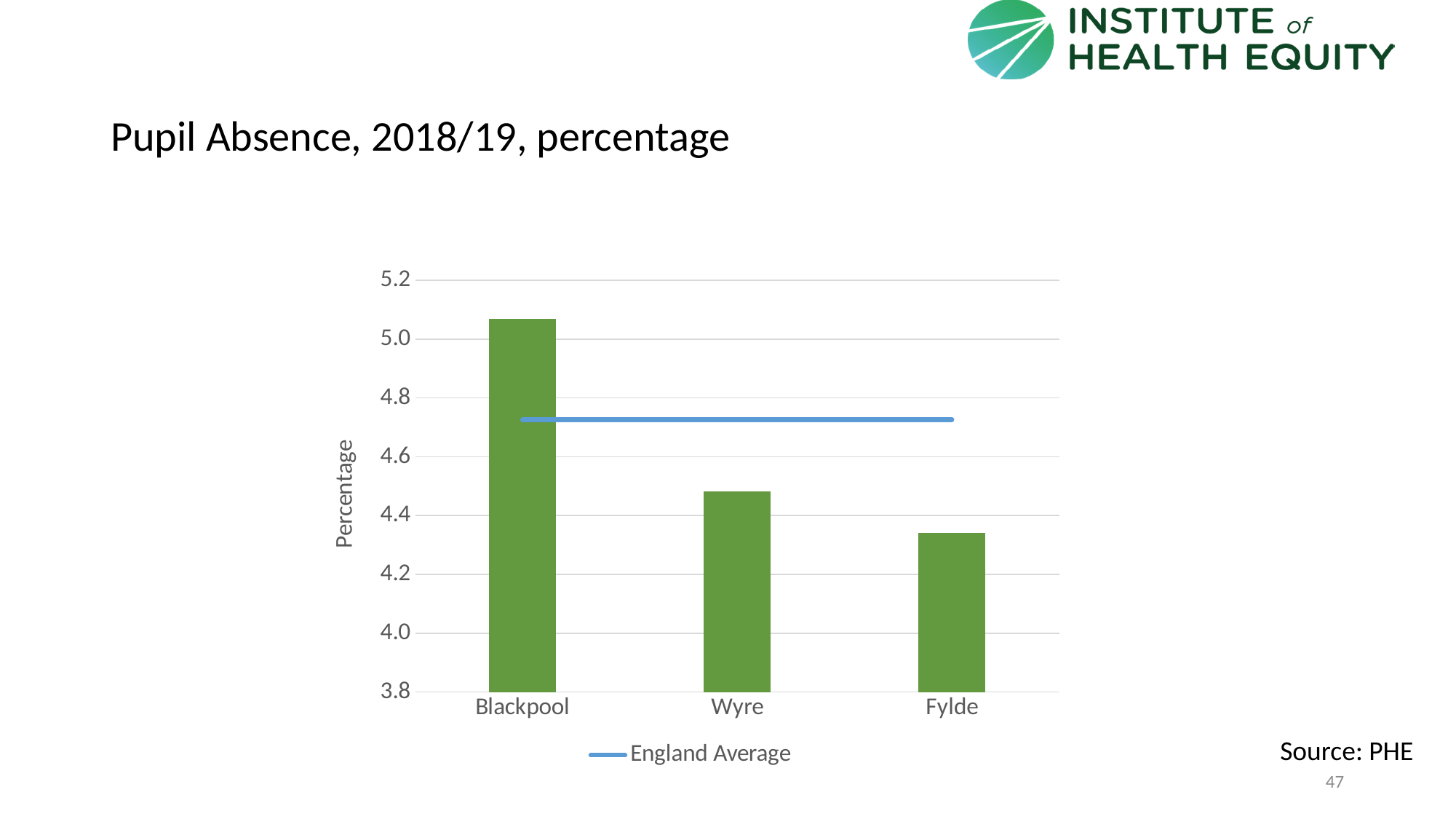
Is Blackpool's pupil absence above or below the England Average line? above Is the pupil absence value for Wyre greater or less than 4.6? less How many areas are shown as bars in the chart? 3 Which area has the lowest pupil absence percentage? Fylde What does the blue horizontal line in the chart represent, according to the legend? England Average Is the England Average line greater or less than 4.6? greater What kind of chart is shown on the slide? bar chart Which area has the highest pupil absence percentage? Blackpool Is the pupil absence value for Blackpool greater or less than 5.0? greater Do the bar values rise or fall from Blackpool to Fylde? fall Which has a higher pupil absence percentage, Wyre or Fylde? Wyre